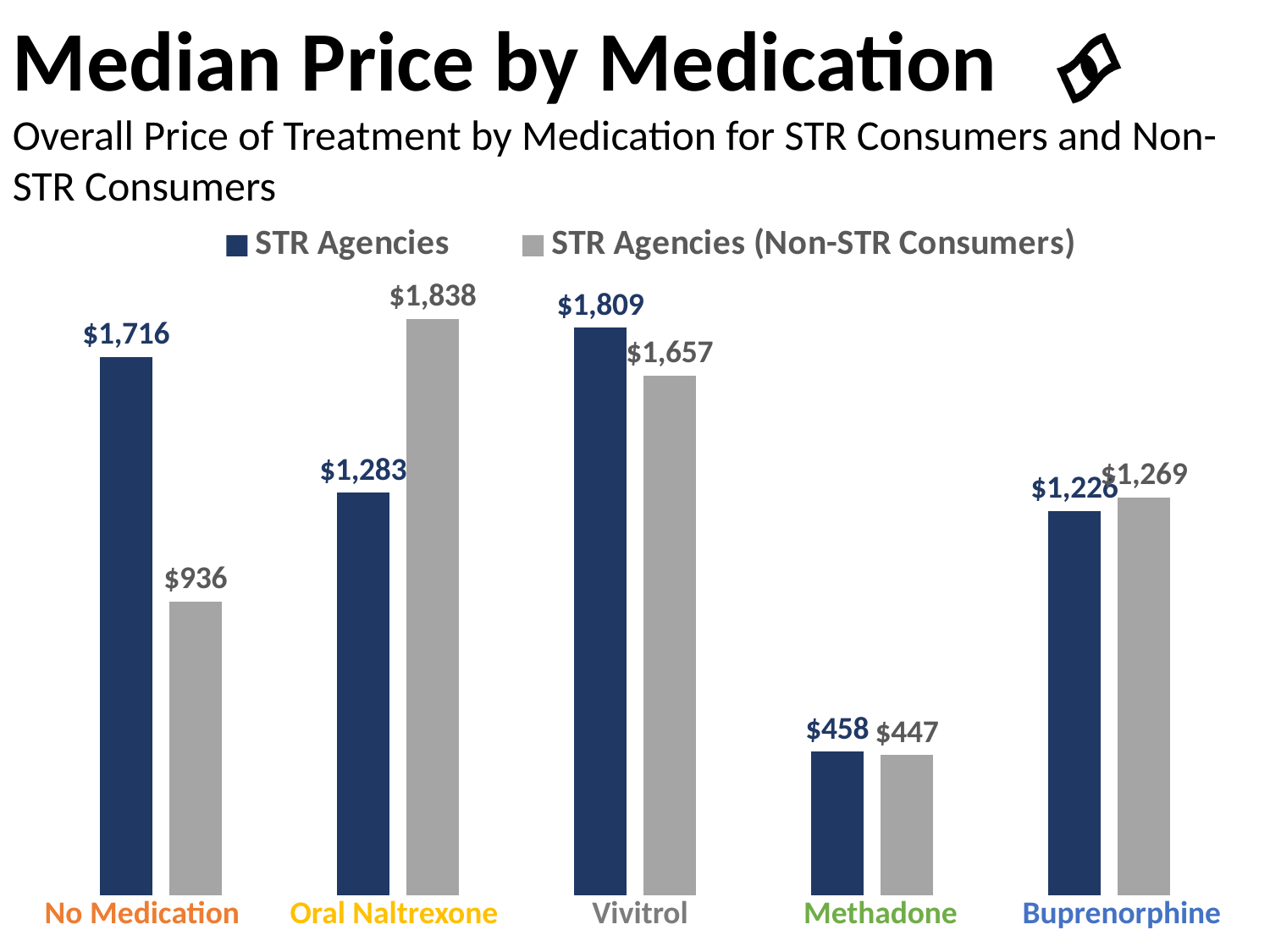
What is the median price for Vivitrol for STR Agencies? $1,809 What kind of chart is shown on the slide? Bar chart Which medication has the highest median price for STR Agencies? Vivitrol What is the median price for Oral Naltrexone for STR Agencies (Non-STR Consumers)? $1,838 What is the difference between the STR Agencies and STR Agencies (Non-STR Consumers) median prices for No Medication? $780 What is the median price for No Medication for STR Agencies? $1,716 How many series does the legend list? 2 Which medication has the lowest median price for STR Agencies (Non-STR Consumers)? Methadone How many medication categories are shown on the chart? 5 What is the median price for Methadone for STR Agencies (Non-STR Consumers)? $447 What is the difference between the STR Agencies and STR Agencies (Non-STR Consumers) median prices for Vivitrol? $152 For Oral Naltrexone, which series has the higher median price: STR Agencies or STR Agencies (Non-STR Consumers)? STR Agencies (Non-STR Consumers)